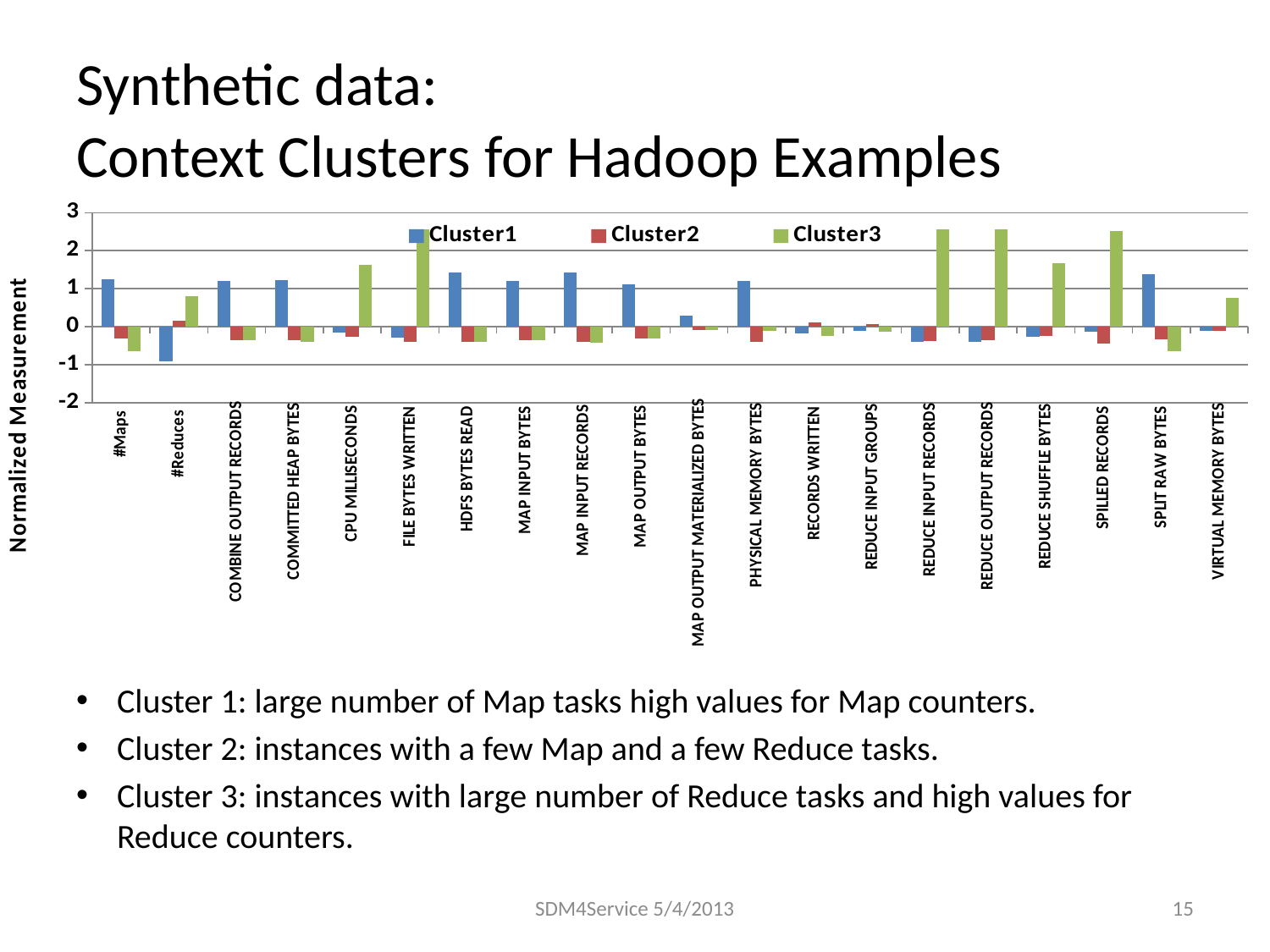
Is the Cluster1 value for #Reduces greater or less than 0? less What kind of chart is shown on the slide? bar chart For REDUCE INPUT RECORDS, which series has the larger value, Cluster1 or Cluster3? Cluster3 What is the label on the vertical axis of the chart? Normalized Measurement Is the Cluster3 value for REDUCE INPUT RECORDS greater or less than 2? greater Is the Cluster1 value for #Maps greater or less than 1? greater How many categories are plotted along the x axis of the chart? 20 Which colour represents Cluster3 in the chart's legend? green For #Maps, which series has the larger value, Cluster1 or Cluster3? Cluster1 Which category has the lowest Cluster1 value? #Reduces How many series does the chart's legend list? 3